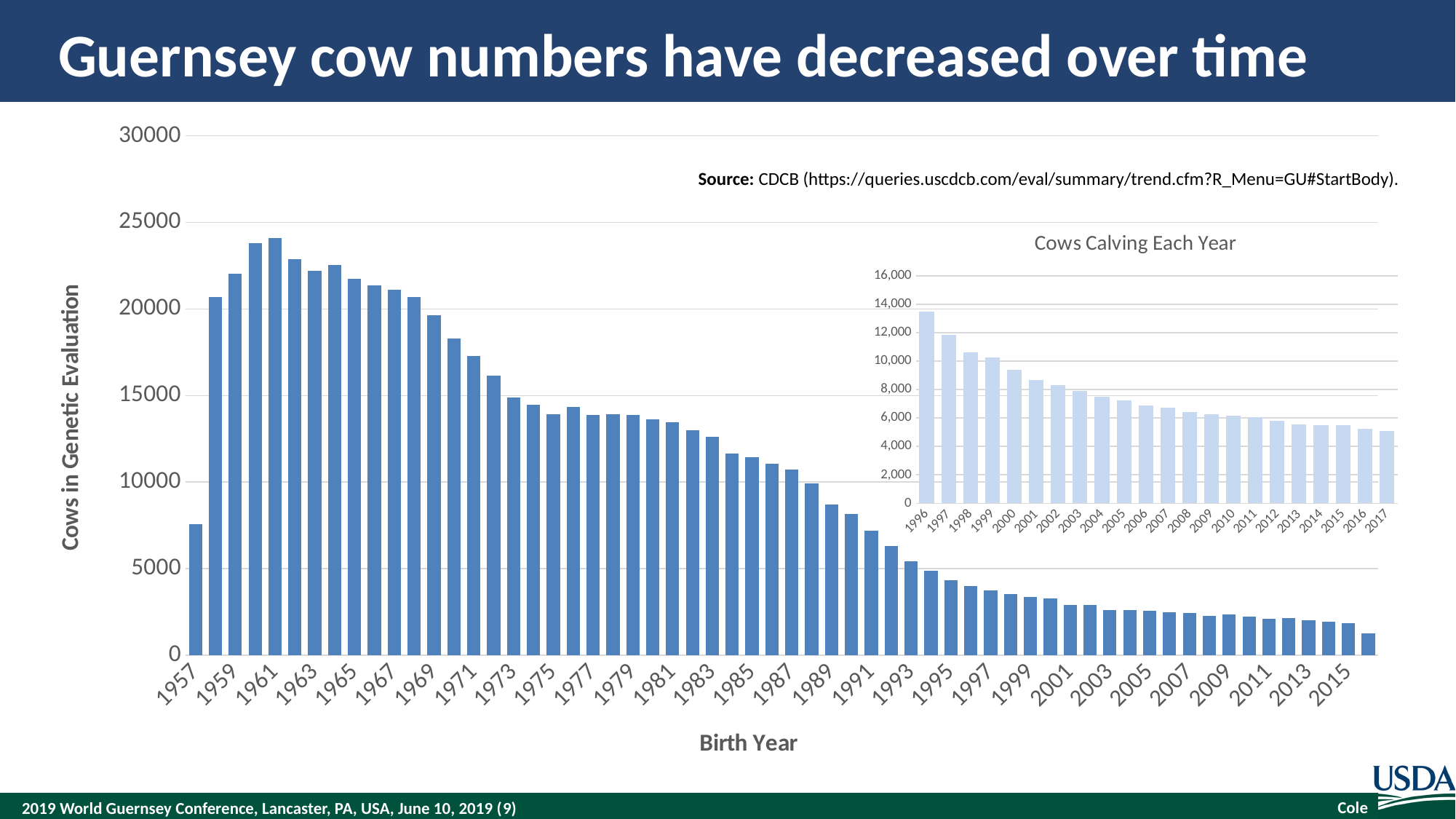
What kind of chart is the main chart on the left showing Cows in Genetic Evaluation by Birth Year? bar chart In the main chart (Cows in Genetic Evaluation), is the value for birth year 2015 greater or less than 5000? less In the main chart (Cows in Genetic Evaluation), which birth year has the highest value? 1961 In the main chart (Cows in Genetic Evaluation), is the value for birth year 1957 greater or less than 10000? less What is the y-axis label of the main chart on the left? Cows in Genetic Evaluation In the inset chart titled Cows Calving Each Year, how many years are plotted? 22 In the main chart (Cows in Genetic Evaluation), do the values rise or fall from birth year 1961 to 2015? fall In the main chart (Cows in Genetic Evaluation), is the value for birth year 1961 greater or less than 20000? greater In the inset chart titled Cows Calving Each Year, which year has the highest value? 1996 In the main chart (Cows in Genetic Evaluation), which birth year has the larger value, 1969 or 1979? 1969